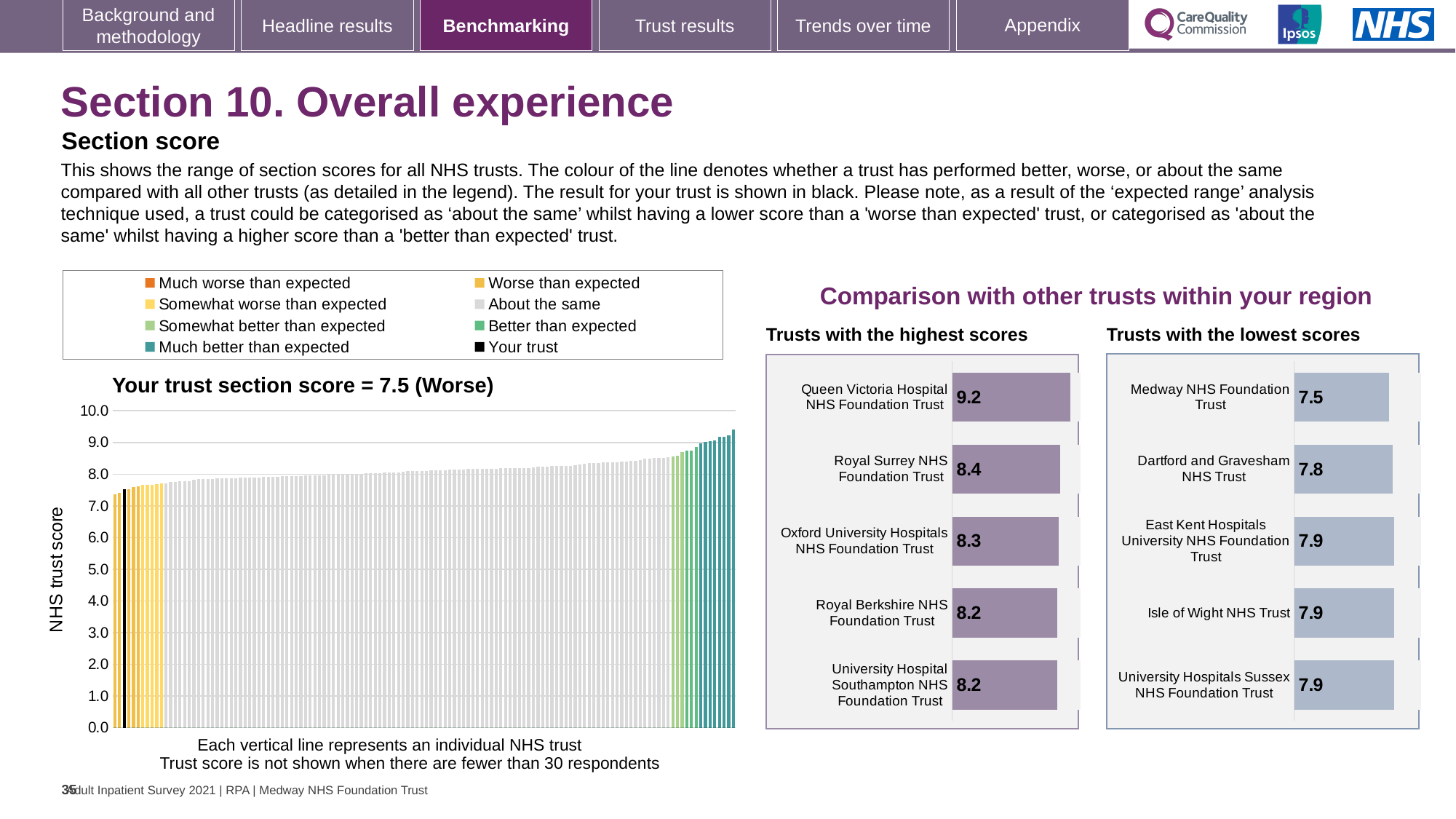
In the 'Trusts with the lowest scores' chart, what is the difference between the scores of Isle of Wight NHS Trust and Medway NHS Foundation Trust? 0.4 In the 'Trusts with the lowest scores' chart, which trust has the lowest score? Medway NHS Foundation Trust In the 'Trusts with the highest scores' chart, which trust has the highest score? Queen Victoria Hospital NHS Foundation Trust How many trusts are listed in the 'Trusts with the lowest scores' chart? 5 In the 'Trusts with the lowest scores' chart, what is the score for Dartford and Gravesham NHS Trust? 7.8 In the 'Your trust section score' chart, do the trust scores rise or fall from left to right? Rise Which is larger: the score for Royal Surrey NHS Foundation Trust in the highest scores chart or the score for East Kent Hospitals University NHS Foundation Trust in the lowest scores chart? Royal Surrey NHS Foundation Trust In the 'Trusts with the highest scores' chart, what is the score for Oxford University Hospitals NHS Foundation Trust? 8.3 In the 'Trusts with the highest scores' chart, what is the score for Queen Victoria Hospital NHS Foundation Trust? 9.2 In the 'Trusts with the highest scores' chart, what is the difference between the scores of Queen Victoria Hospital NHS Foundation Trust and Royal Surrey NHS Foundation Trust? 0.8 What is the section score for your trust shown in the title of the 'Your trust section score' chart? 7.5 (Worse) What type of chart is the 'Your trust section score' chart? Bar chart